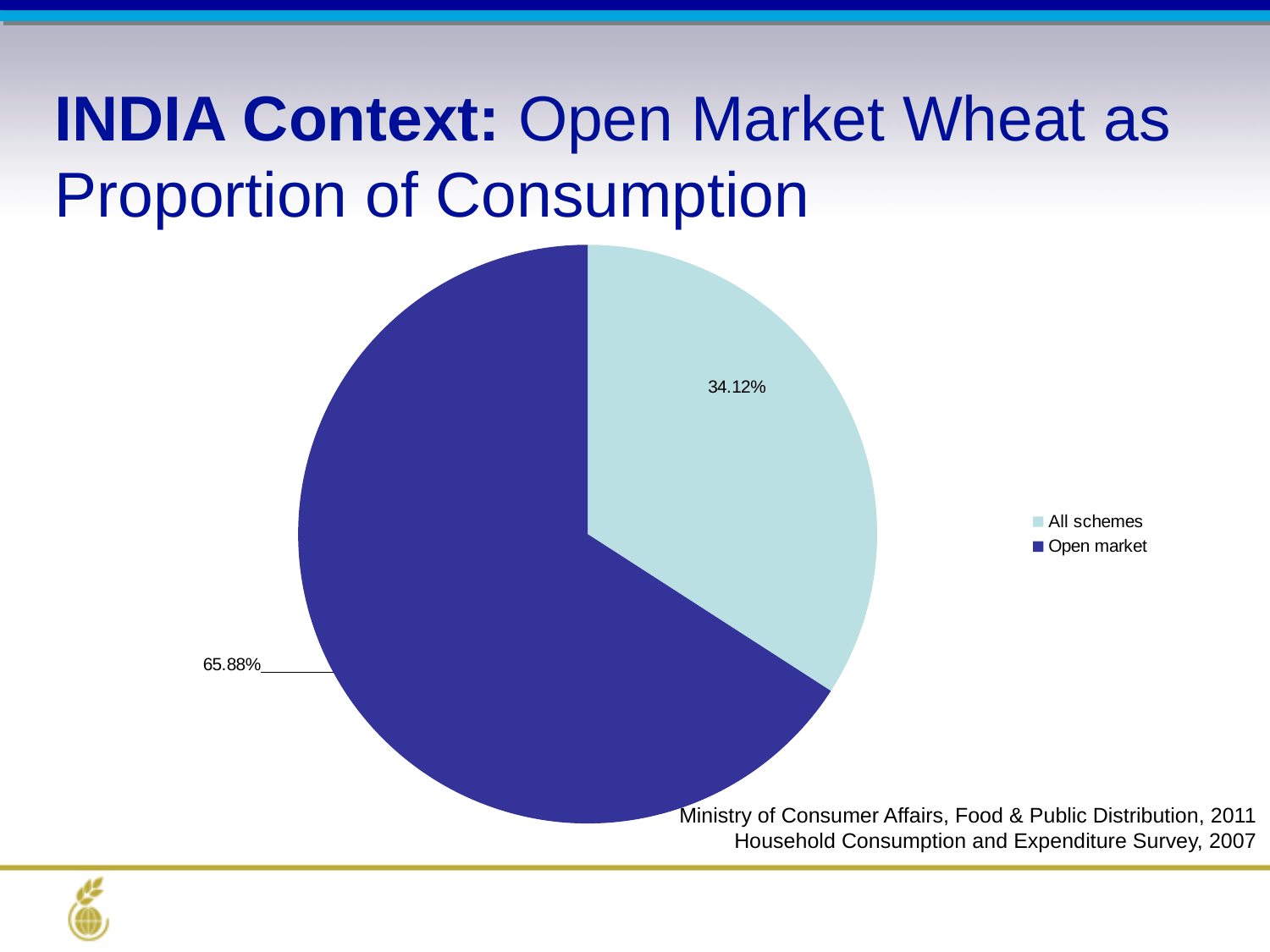
Which slice of the pie is the smallest? All schemes What colour is the Open market slice? dark blue What colour is the All schemes slice? light blue How many entries does the legend list? 2 How many slices does the pie chart have? 2 What kind of chart is shown on the slide? pie chart What share of the pie does the Open market slice represent? 65.88% What share of the pie does the All schemes slice represent? 34.12% What is the difference in percentage points between the Open market slice and the All schemes slice? 31.76 Which slice of the pie is the largest? Open market Which is larger, the Open market slice or the All schemes slice? Open market